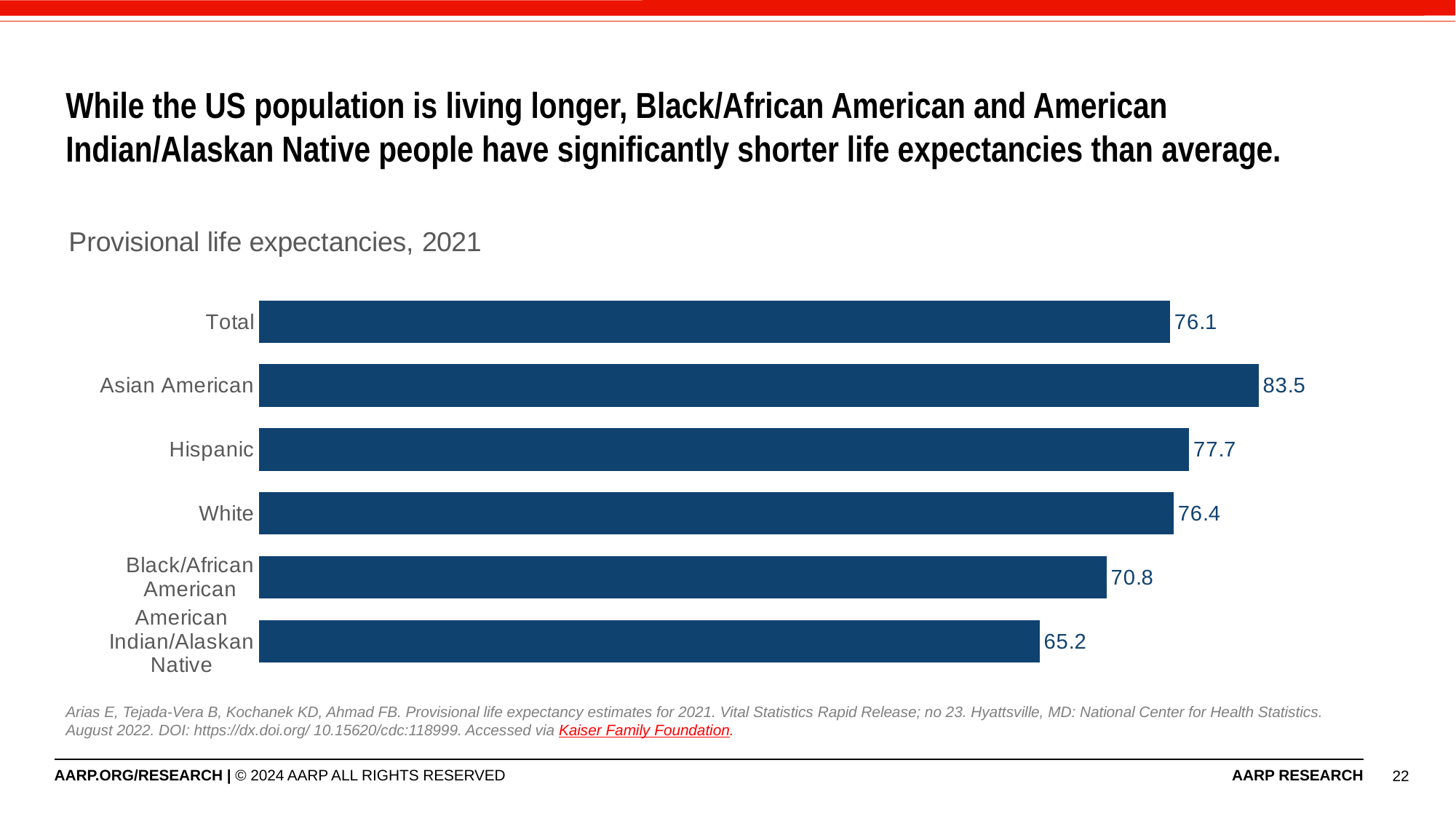
How many categories are shown in the chart? 6 What is the title of the chart? Provisional life expectancies, 2021 What is the provisional life expectancy for the Total category? 76.1 Which category has the lowest provisional life expectancy? American Indian/Alaskan Native Which is larger, the life expectancy for Hispanic people or for Black/African American people? Hispanic Which category has the highest provisional life expectancy? Asian American What kind of chart is shown on the slide? Bar chart What is the difference between the life expectancy for Hispanic and White people? 1.3 What is the provisional life expectancy for Black/African American people? 70.8 What is the provisional life expectancy for Asian American people? 83.5 What is the provisional life expectancy for American Indian/Alaskan Native people? 65.2 What is the difference between the life expectancy for Asian American and American Indian/Alaskan Native people? 18.3